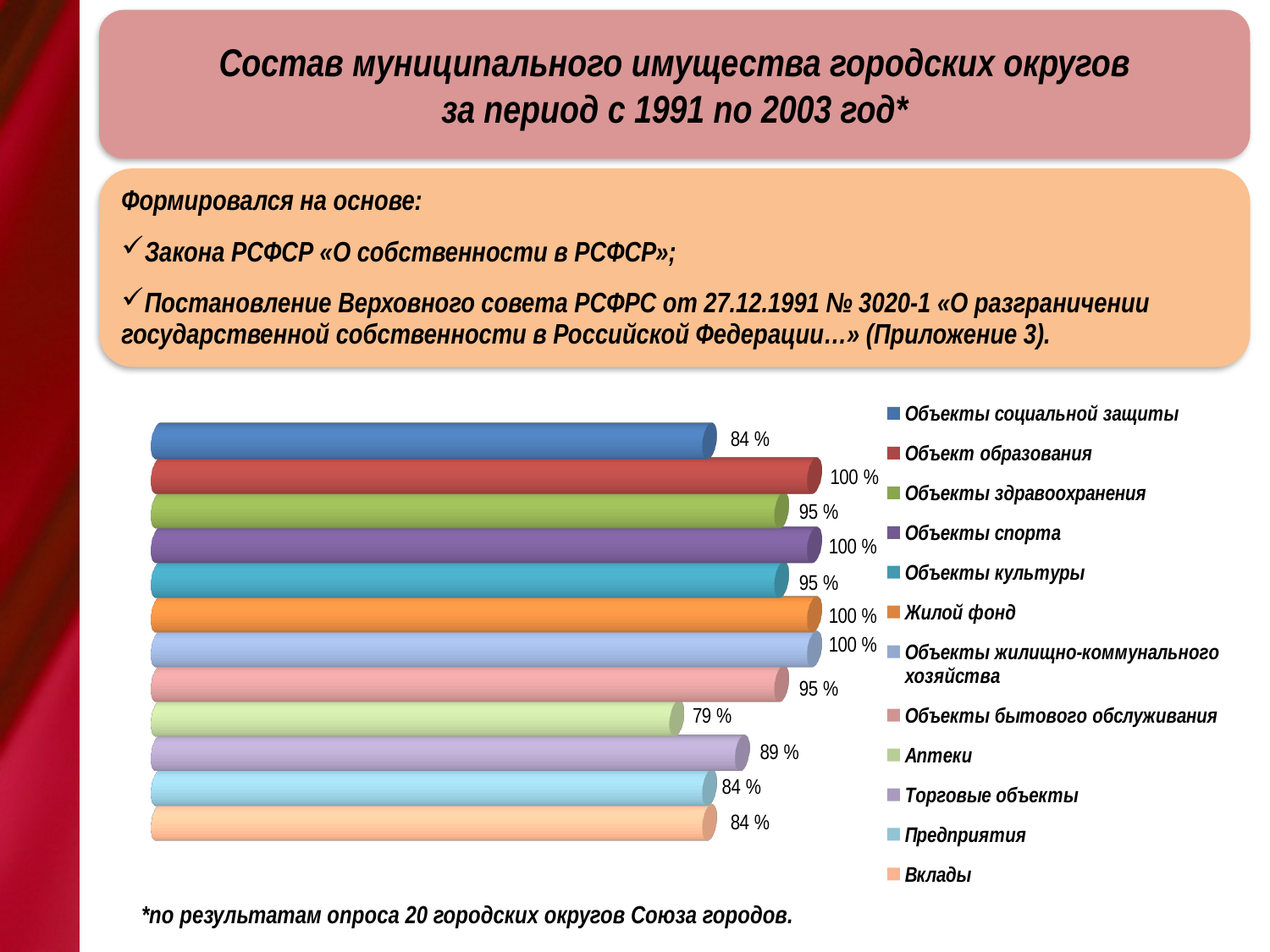
What is the value shown for Аптеки? 79 % What is the value shown for Объекты здравоохранения? 95 % How many categories are plotted in the chart? 12 What is the difference between the values for Объект образования and Аптеки? 21 % Which category has the lowest value in the chart? Аптеки What colour is the bar for Жилой фонд? Orange What is the difference between the values for Торговые объекты and Предприятия? 5 % Which is larger, the value for Объекты культуры or the value for Вклады? Объекты культуры What is the value shown for Торговые объекты? 89 % What is the value shown for Жилой фонд? 100 % How many categories have a value of 100 %? 4 What kind of chart is shown on the slide? Bar chart